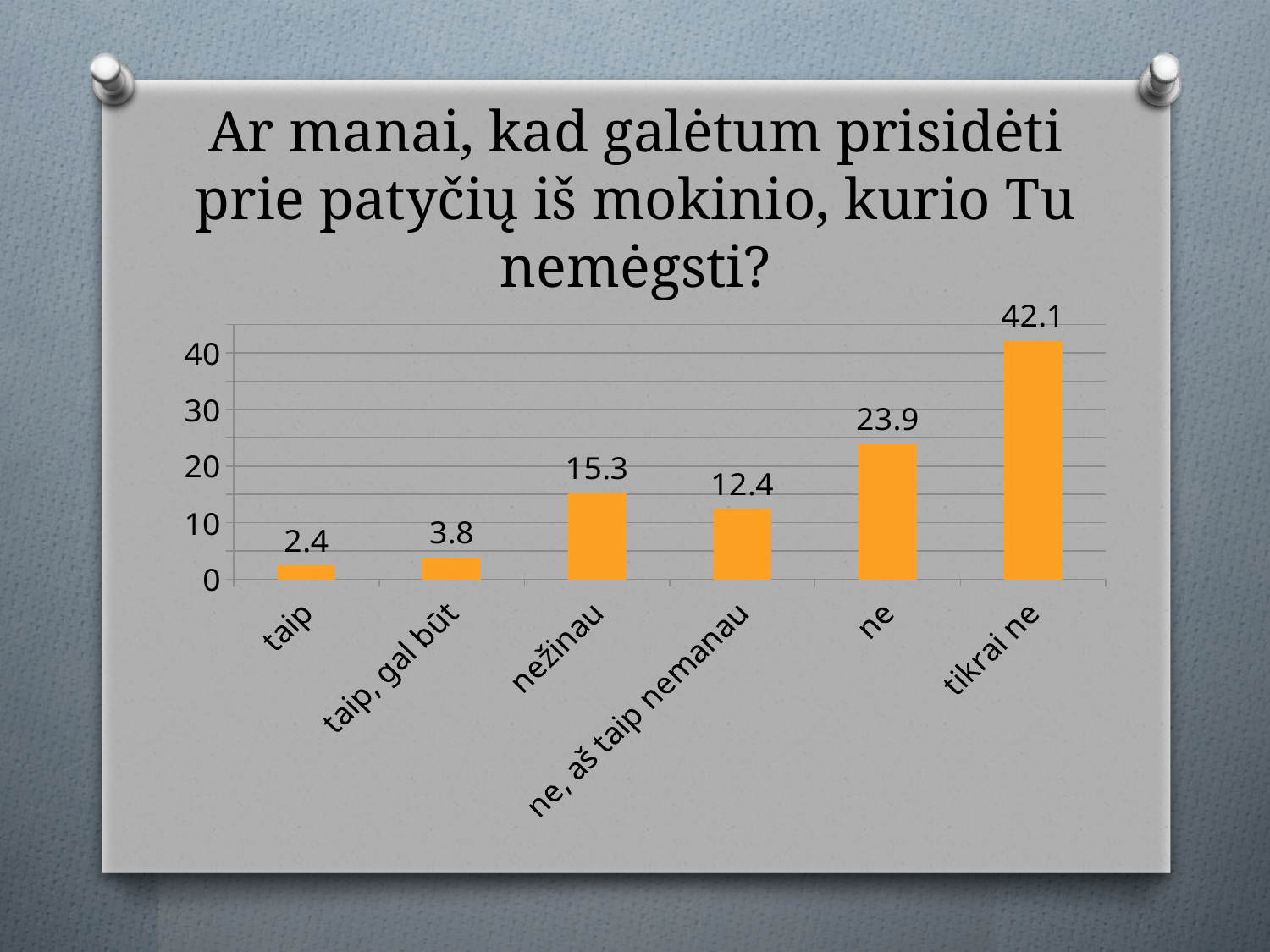
Which category has the highest value? tikrai ne What kind of chart is shown on the slide? bar chart Which is larger, the value for "ne" or the value for "nežinau"? ne How many categories are shown on the x axis? 6 What colour are the bars in the chart? orange What is the value for "nežinau"? 15.3 What is the value for "taip, gal būt"? 3.8 What is the difference between the values for "tikrai ne" and "ne"? 18.2 What is the value for "tikrai ne"? 42.1 Which category has the lowest value? taip Is the value for "ne" greater or less than 20? greater What is the difference between the values for "nežinau" and "ne, aš taip nemanau"? 2.9